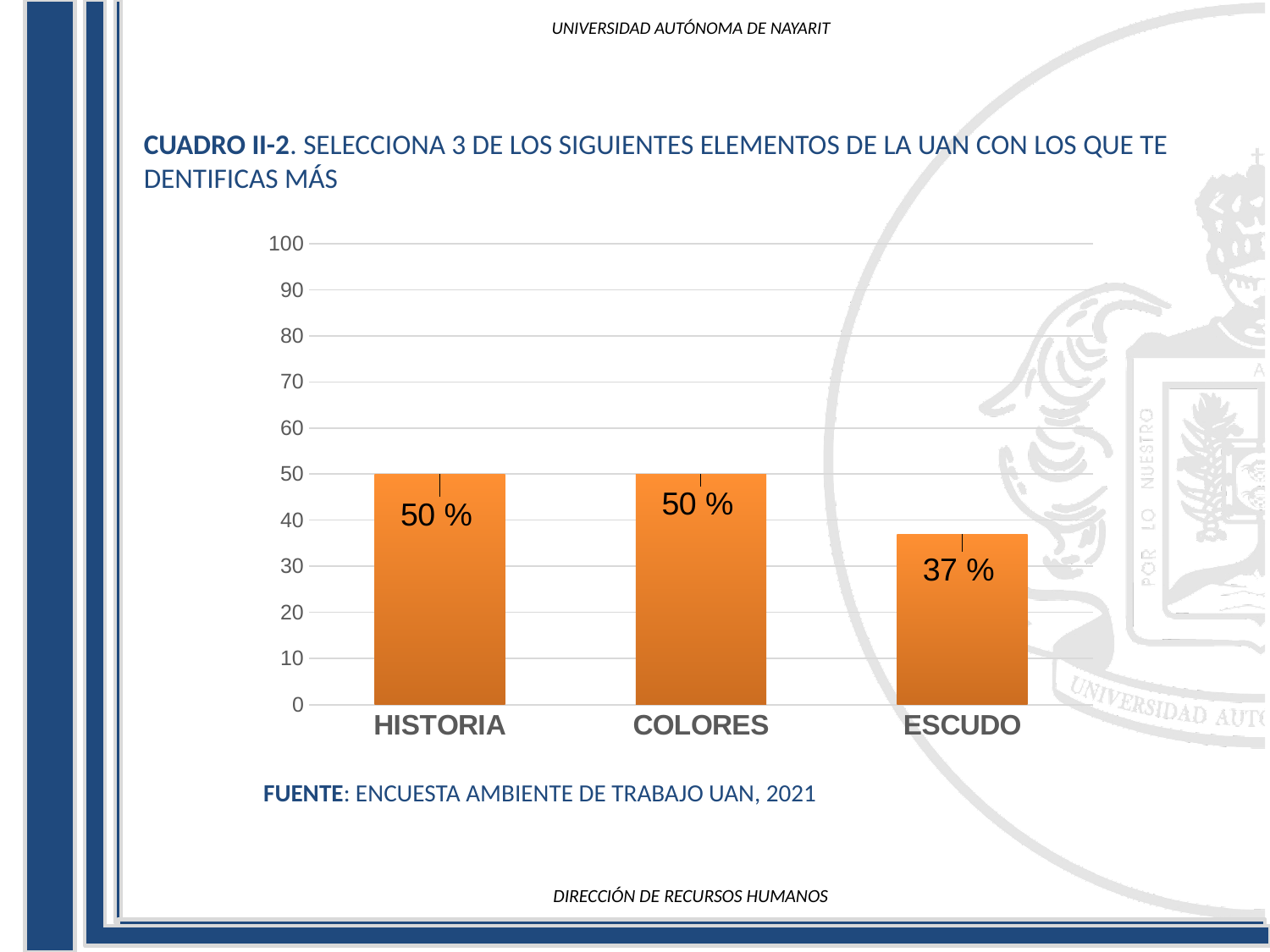
How many categories are shown on the x axis? 3 What source is cited below the chart? ENCUESTA AMBIENTE DE TRABAJO UAN, 2021 Is the value for ESCUDO greater or less than 40? less Which is larger, the value for COLORES or the value for ESCUDO? COLORES Do the values rise or fall from HISTORIA to ESCUDO along the x axis? fall What is the value for HISTORIA? 50 % What is the value for ESCUDO? 37 % What kind of chart is shown on the slide? bar chart What is the highest value shown on the vertical axis? 100 Which category has the lowest value? ESCUDO What is the difference between the values for HISTORIA and ESCUDO? 13 % What is the value for COLORES? 50 %